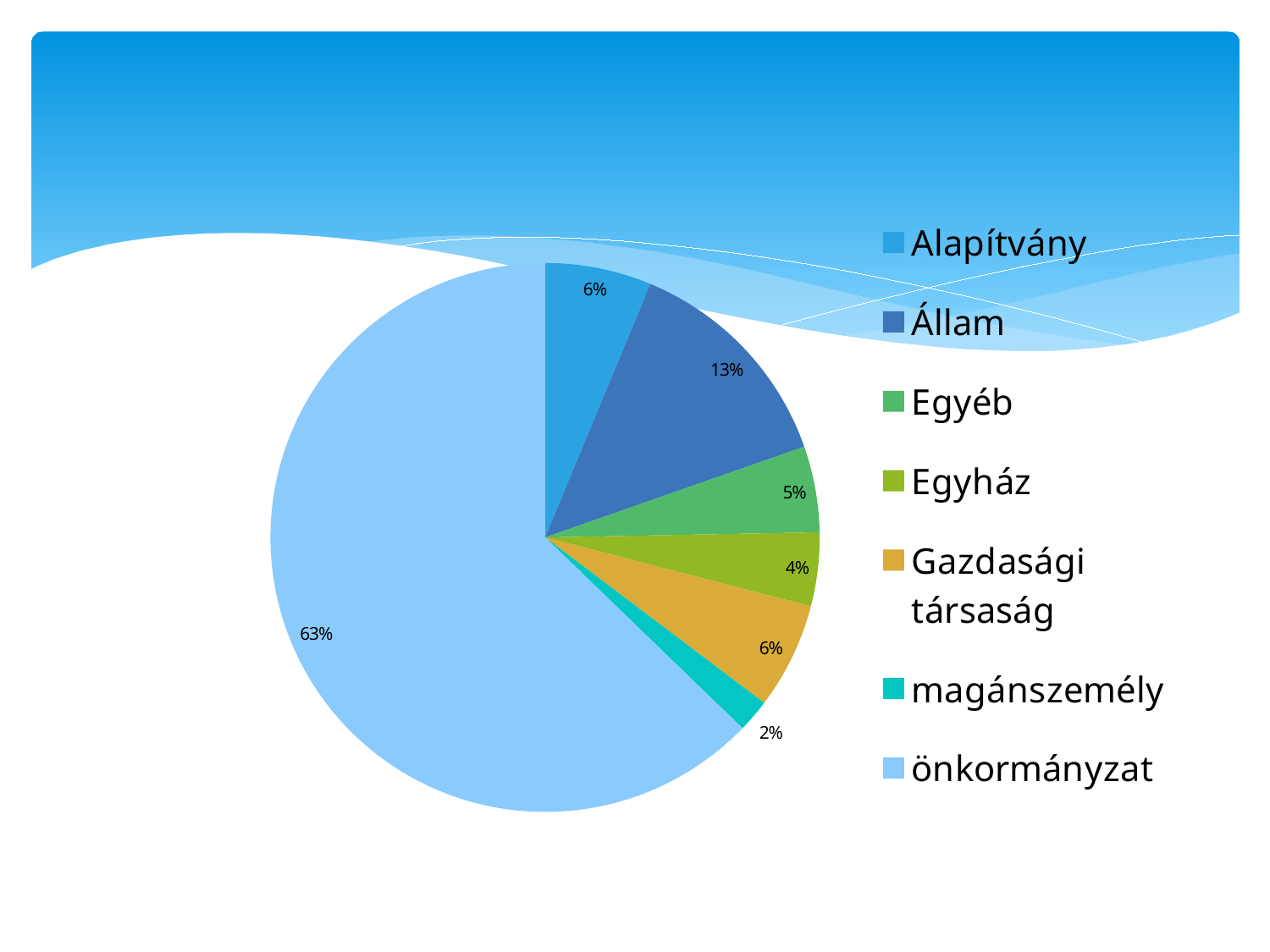
What is the difference between the shares of Állam and Egyéb? 8% Which category has the largest slice of the pie? önkormányzat What is the value shown for Állam? 13% What is the value shown for magánszemély? 2% What kind of chart is shown on the slide? pie chart How many categories does the pie chart have? 7 Which is larger, the share of Egyéb or the share of Egyház? Egyéb What is the value shown for Egyház? 4% Which category has the smallest slice of the pie? magánszemély What share of the pie does önkormányzat have? 63% What is the value shown for Gazdasági társaság? 6% Which legend entry is shown in orange? Gazdasági társaság